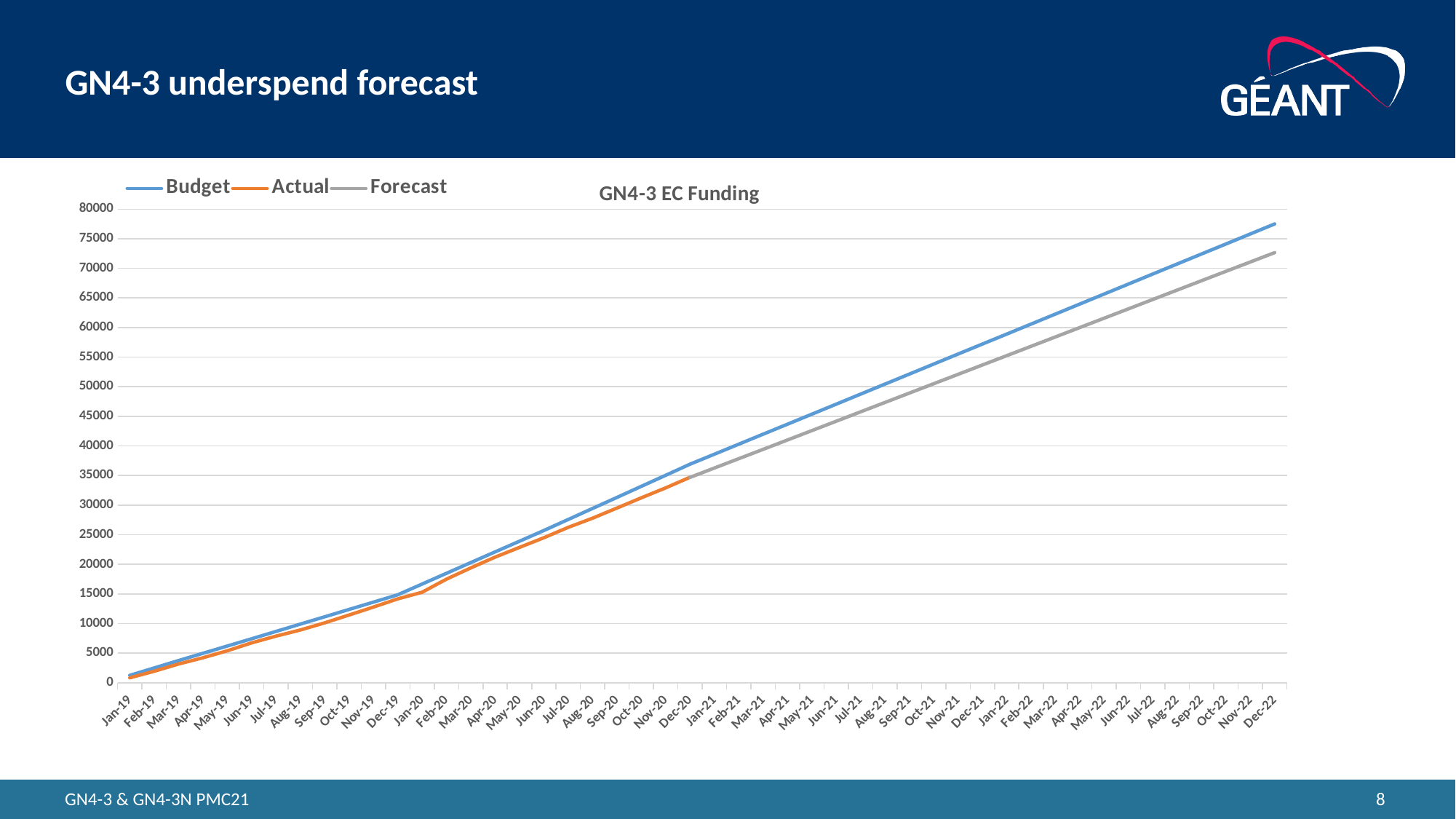
Which series reaches the highest value at Dec-22? Budget How many series does the legend list? 3 At Dec-22, which is larger, the Budget value or the Forecast value? Budget Is the Actual value at Jun-20 greater or less than 30000? less Do the Budget values rise or fall from Jan-19 to Dec-22? rise Is the Forecast value at Dec-22 greater or less than 75000? less Is the Budget value at Dec-22 greater or less than 75000? greater What kind of chart is shown on the slide? line chart How many months are labelled along the x axis? 48 Which series is drawn in orange? Actual What is the title of the chart? GN4-3 EC Funding